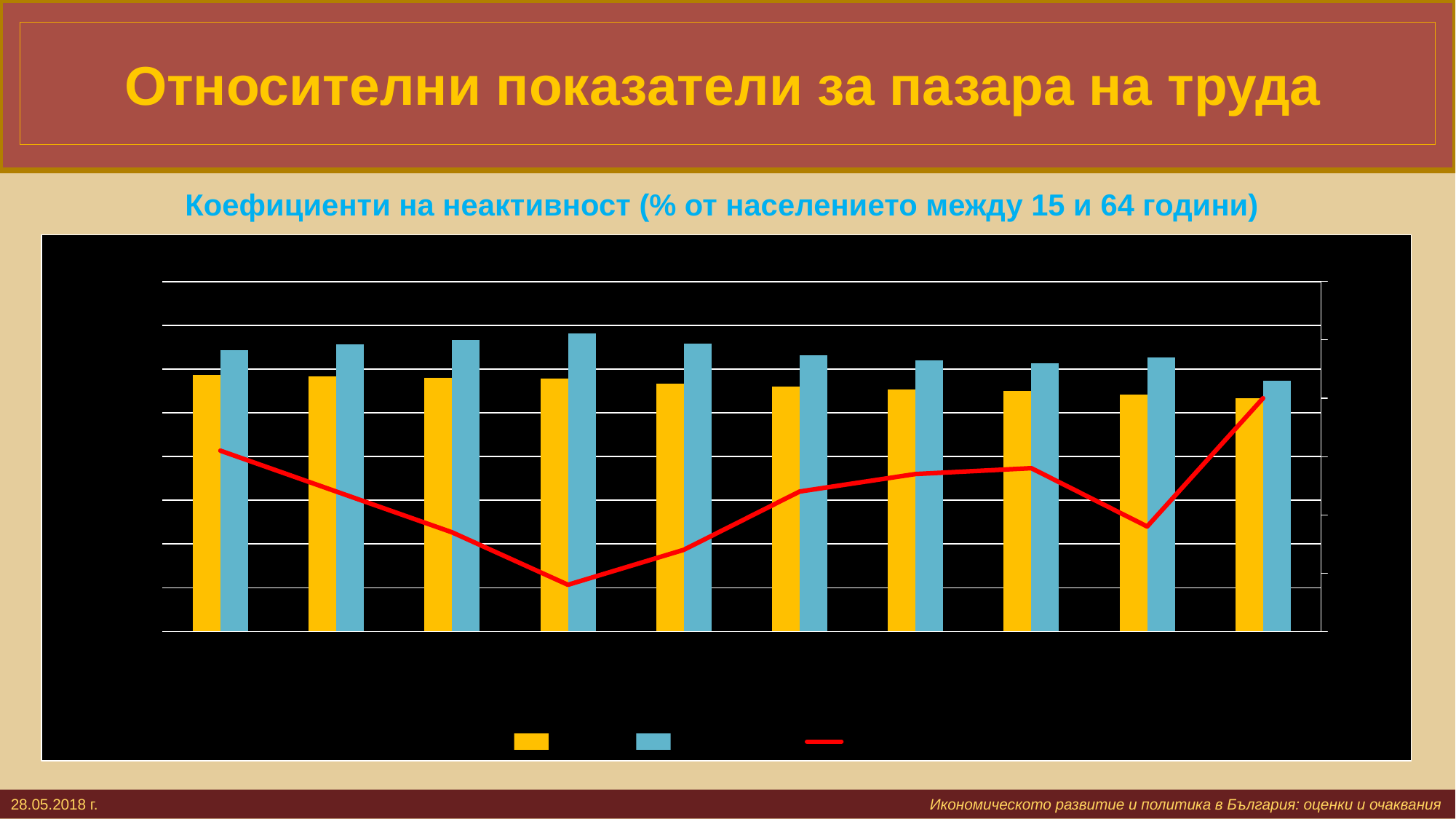
Which series is drawn as a line rather than bars? The red series How many groups of bars are plotted along the x axis? 10 How many series does the legend list? 3 Do the yellow bars rise or fall from left to right along the x axis? Fall What is the title of the chart? Коефициенти на неактивност (% от населението между 15 и 64 години) What kind of chart is shown on the slide? A combined bar and line chart